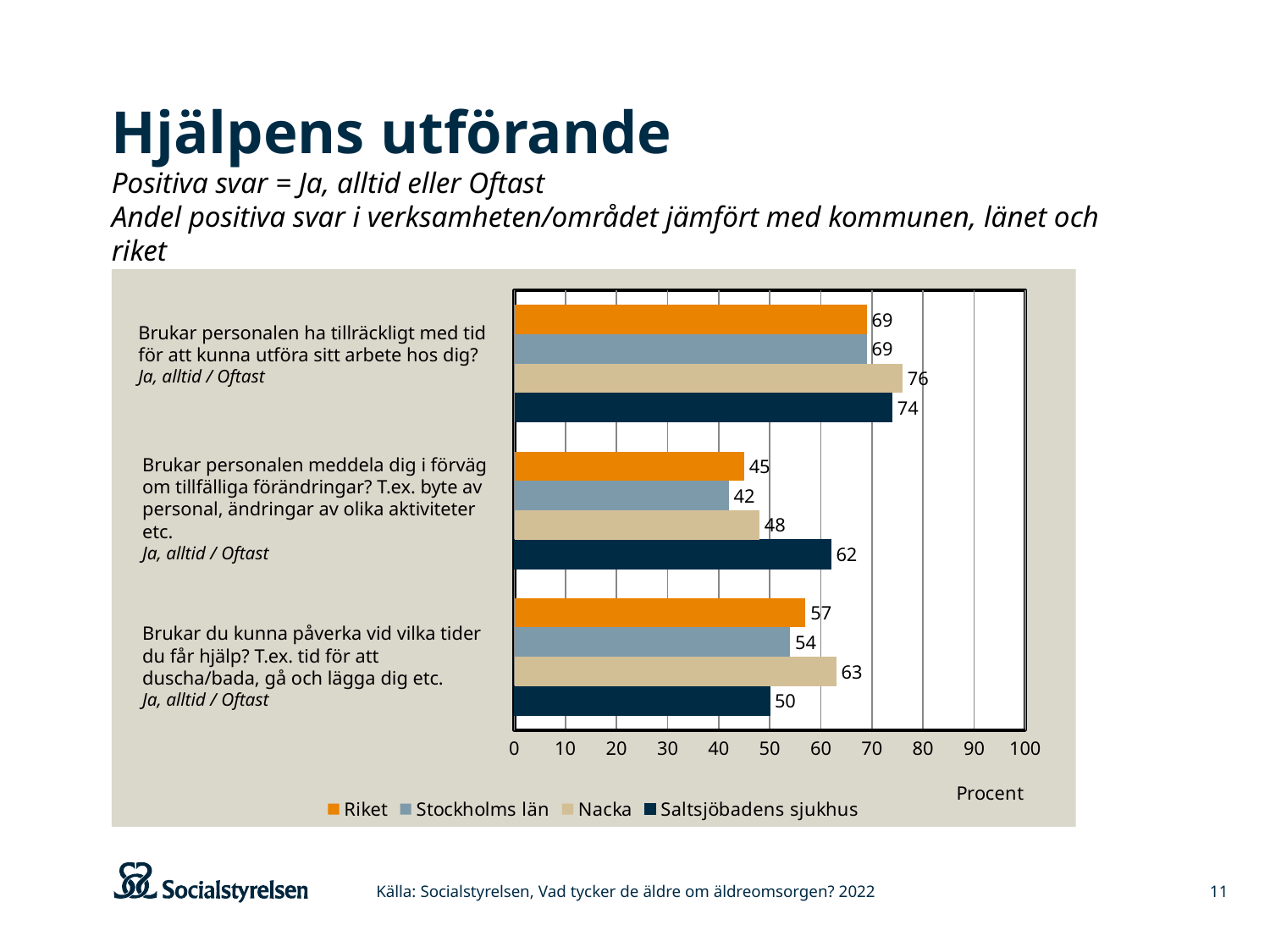
What value is shown for Nacka on the question "Brukar personalen ha tillräckligt med tid för att kunna utföra sitt arbete hos dig?"? 76 On the question "Brukar personalen ha tillräckligt med tid för att kunna utföra sitt arbete hos dig?", which is larger: Nacka or Saltsjöbadens sjukhus? Nacka What unit label is shown below the x axis of the chart? Procent Which series has the lowest value on the question "Brukar personalen meddela dig i förväg om tillfälliga förändringar?"? Stockholms län What is the difference between Saltsjöbadens sjukhus and Riket on the question "Brukar personalen meddela dig i förväg om tillfälliga förändringar?"? 17 What value is shown for Riket on the question "Brukar du kunna påverka vid vilka tider du får hjälp?"? 57 Which series has the highest value on the question "Brukar du kunna påverka vid vilka tider du får hjälp?"? Nacka Is the value for Saltsjöbadens sjukhus on the question "Brukar du kunna påverka vid vilka tider du får hjälp?" greater or less than 60? less How many questions (categories) are shown in the chart? 3 What value is shown for Saltsjöbadens sjukhus on the question "Brukar personalen meddela dig i förväg om tillfälliga förändringar?"? 62 What kind of chart is shown on the slide? Bar chart How many series does the legend list? 4